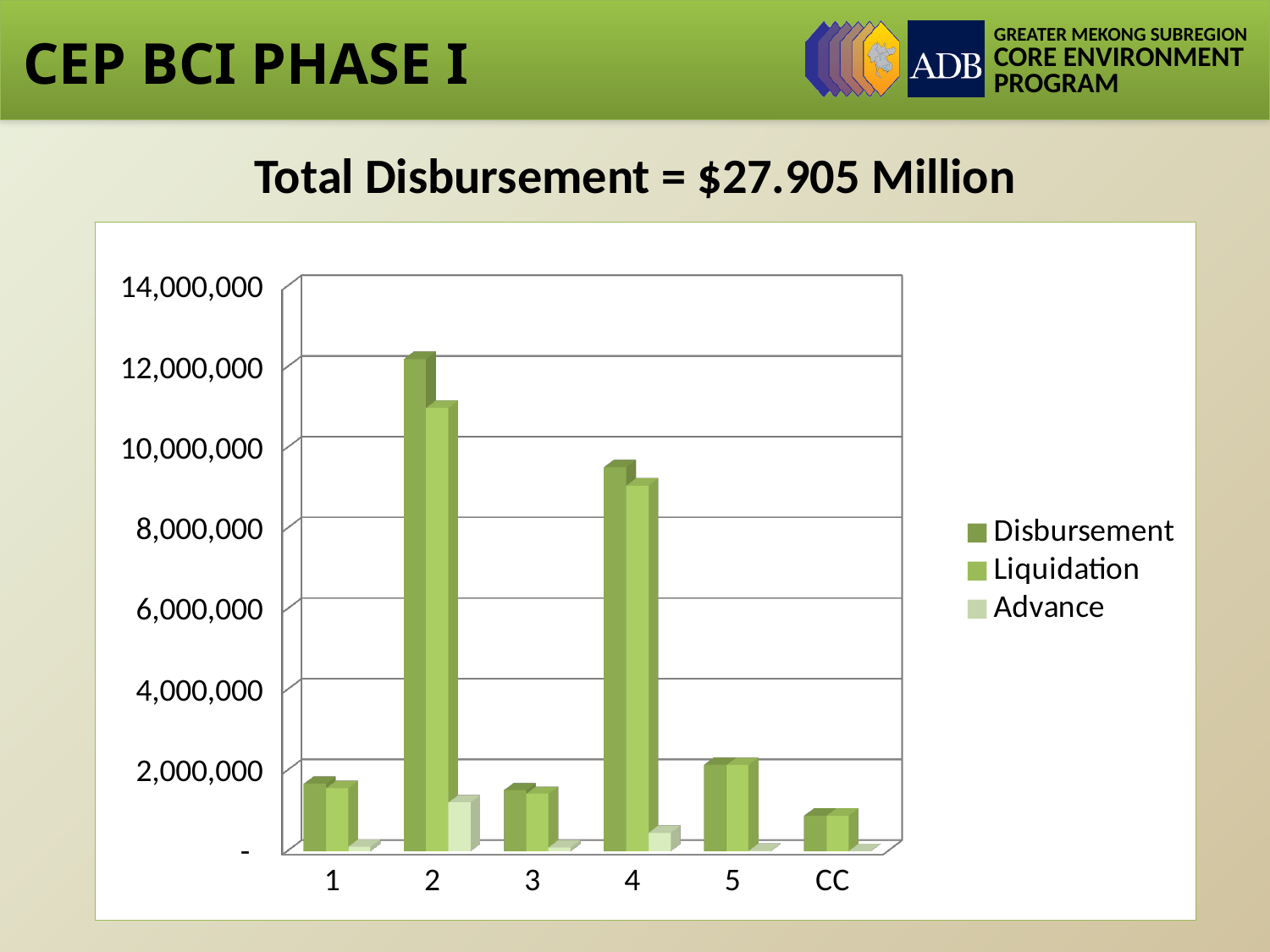
Is the Disbursement value for category 4 greater or less than 10,000,000? less Which is larger, the Disbursement value for category 5 or for CC? Category 5 Which category has the lowest Disbursement value? CC How many series does the chart legend list? 3 How many categories are shown on the x axis of the chart? 6 Which category has the highest Disbursement value? 2 Which category has the highest Advance value? 2 What total disbursement figure is stated in the title above the chart? $27.905 Million Which is larger, the Disbursement value for category 2 or for category 4? Category 2 Is the Disbursement value for category 2 greater or less than 10,000,000? greater Is the Disbursement value for category 1 greater or less than 2,000,000? less What kind of chart is shown on the slide? Bar chart